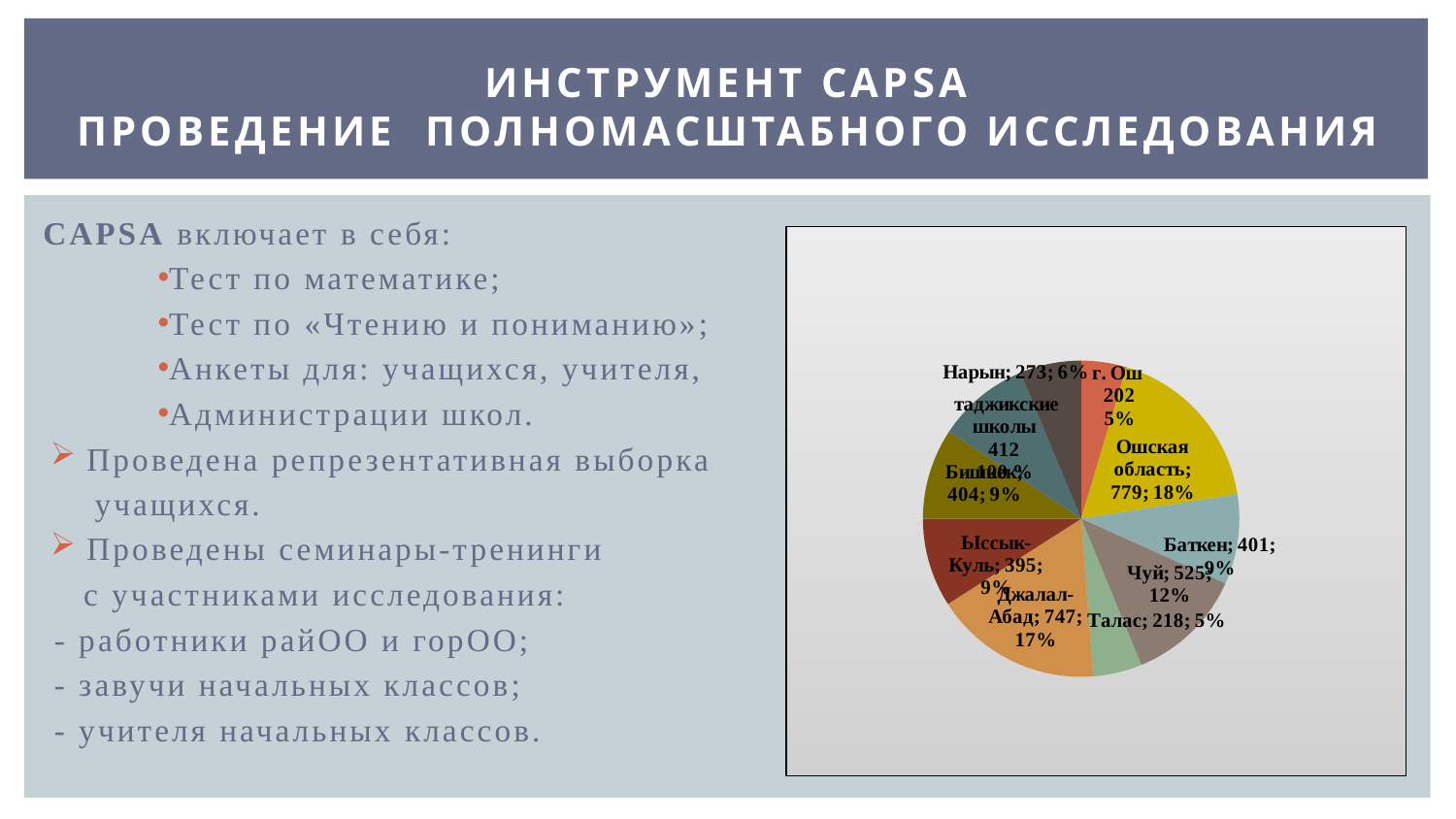
Which category has the largest slice in the pie chart? Ошская область What is the value for Ошская область in the pie chart? 779 What kind of chart is shown on the slide? pie chart What share of the pie does Джалал-Абад represent? 17% What share of the pie does Нарын represent? 6% Which category has the smallest slice in the pie chart? г. Ош What is the difference between the values for Ошская область and Джалал-Абад? 32 What is the difference between the values for Чуй and Талас? 307 Which is larger in the pie chart, Баткен or Талас? Баткен What is the value for Ыссык-Куль in the pie chart? 395 How many slices does the pie chart have? 10 What is the value for Чуй in the pie chart? 525